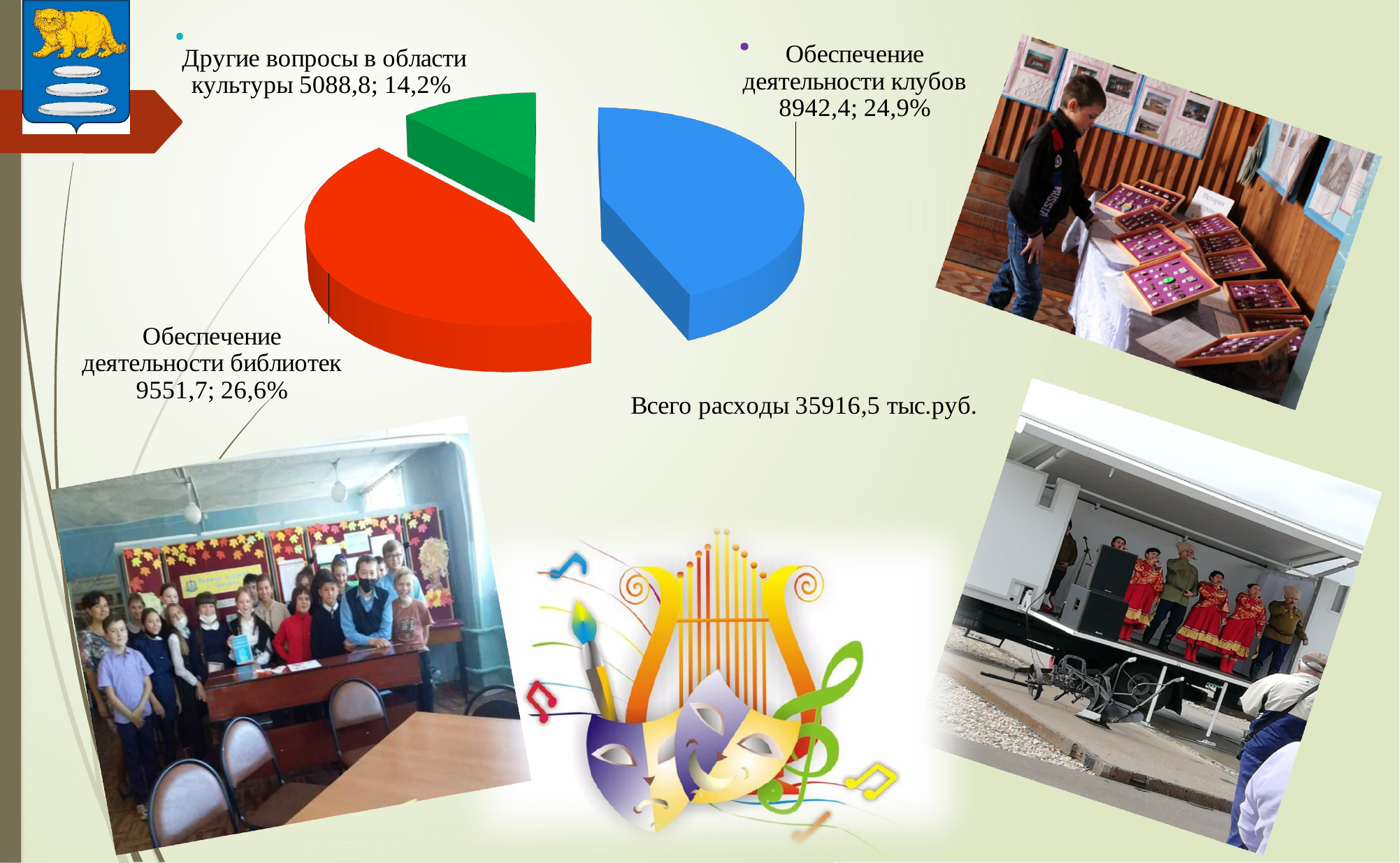
Which category has the largest value in the pie chart? Обеспечение деятельности библиотек What kind of chart is shown on the slide? Pie chart What percentage share is shown for "Другие вопросы в области культуры"? 14,2% What percentage share is shown for "Обеспечение деятельности клубов"? 24,9% What value is shown for "Другие вопросы в области культуры"? 5088,8 Which category has the smallest value in the pie chart? Другие вопросы в области культуры What value is shown for "Обеспечение деятельности библиотек"? 9551,7 What is the difference between the values for "Обеспечение деятельности библиотек" and "Обеспечение деятельности клубов"? 609,3 What value is shown for "Обеспечение деятельности клубов"? 8942,4 What total expenditure is stated on the slide next to the pie chart? 35916,5 тыс.руб. How many slices does the pie chart have? 3 Which is larger: the value for "Обеспечение деятельности клубов" or for "Другие вопросы в области культуры"? Обеспечение деятельности клубов